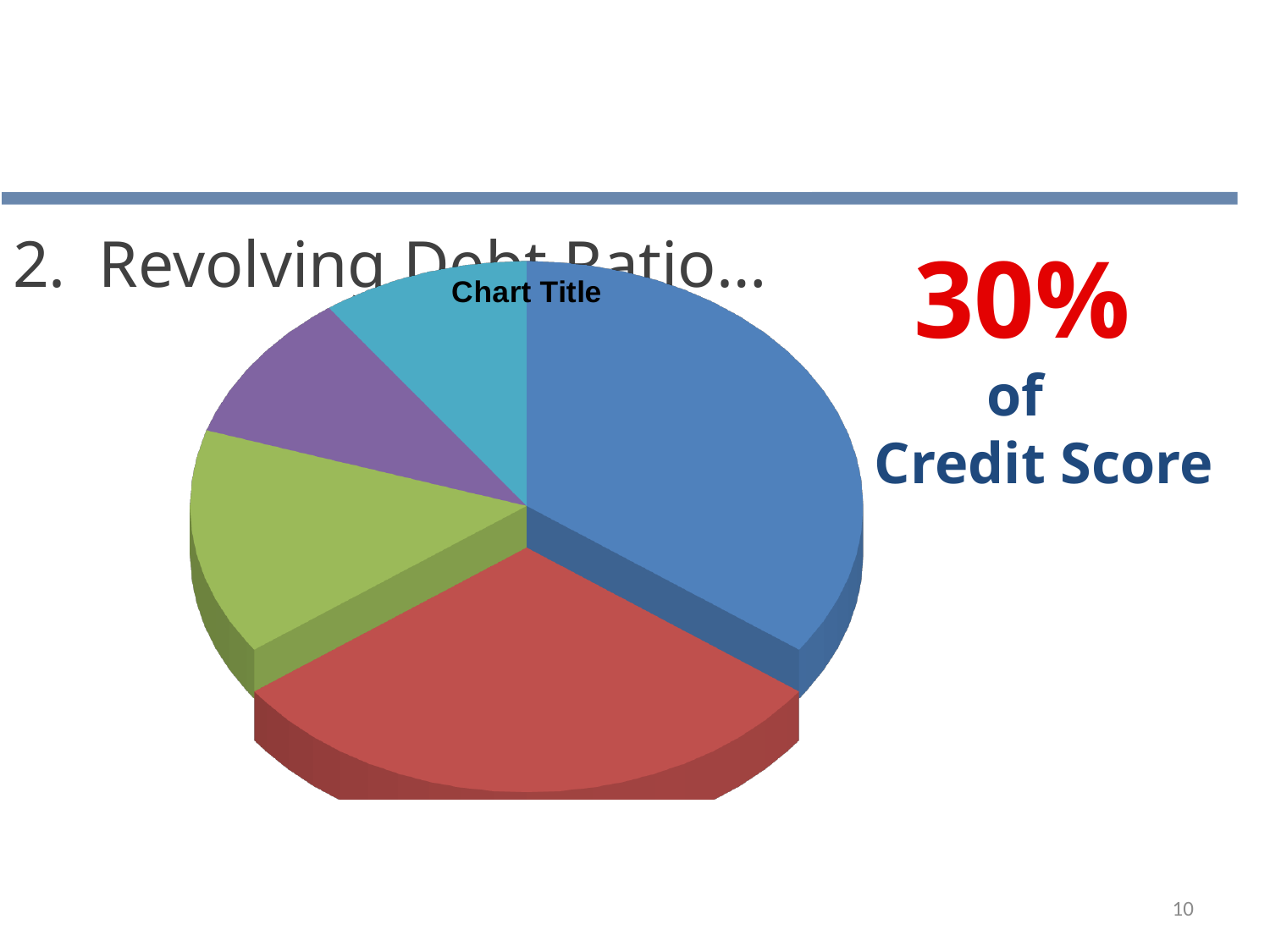
How many slices does the pie chart have? 5 Does the pie chart display a legend? no What kind of chart is shown on the slide? pie chart Which is larger, the blue slice or the green slice? blue Which is larger, the blue slice or the red slice? blue Which is larger, the green slice or the teal slice? green Which colour slice is the largest in the pie chart? blue What is the title shown on the chart? Chart Title